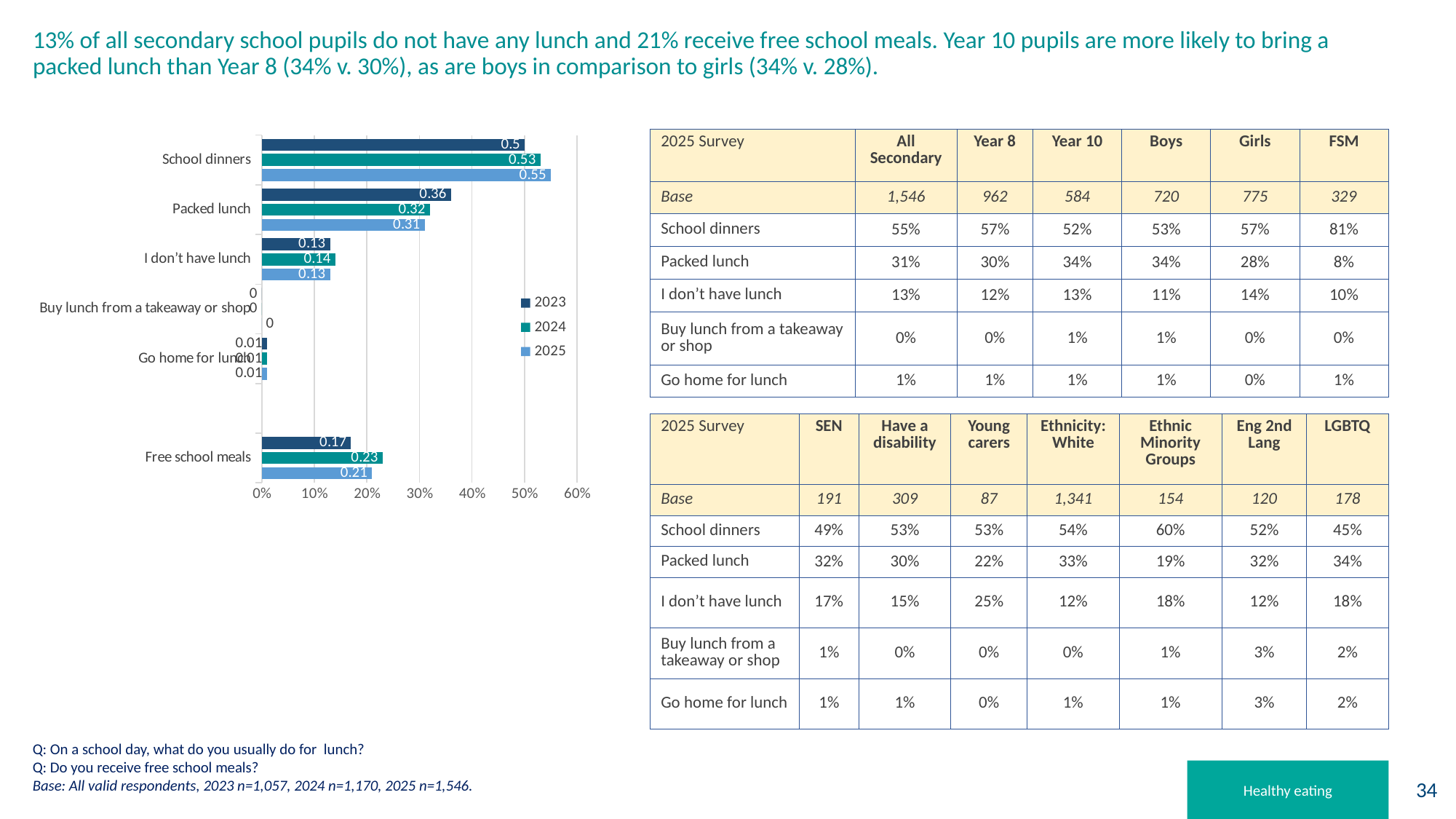
What is the difference between the 2025 and 2023 values for School dinners? 0.05 What is the difference between the 2024 and 2023 values for Free school meals? 0.06 What kind of chart is shown on the slide? Bar chart What is the value for School dinners in the 2025 series? 0.55 Which is larger in the 2023 series: School dinners or Packed lunch? School dinners What is the value for I don't have lunch in the 2024 series? 0.14 Which category has the highest value in the 2025 series? School dinners What is the value for Packed lunch in the 2023 series? 0.36 How many series does the chart's legend list? 3 How many categories are shown on the chart? 6 Which category has the lowest value in the 2025 series? Buy lunch from a takeaway or shop What is the value for Free school meals in the 2024 series? 0.23